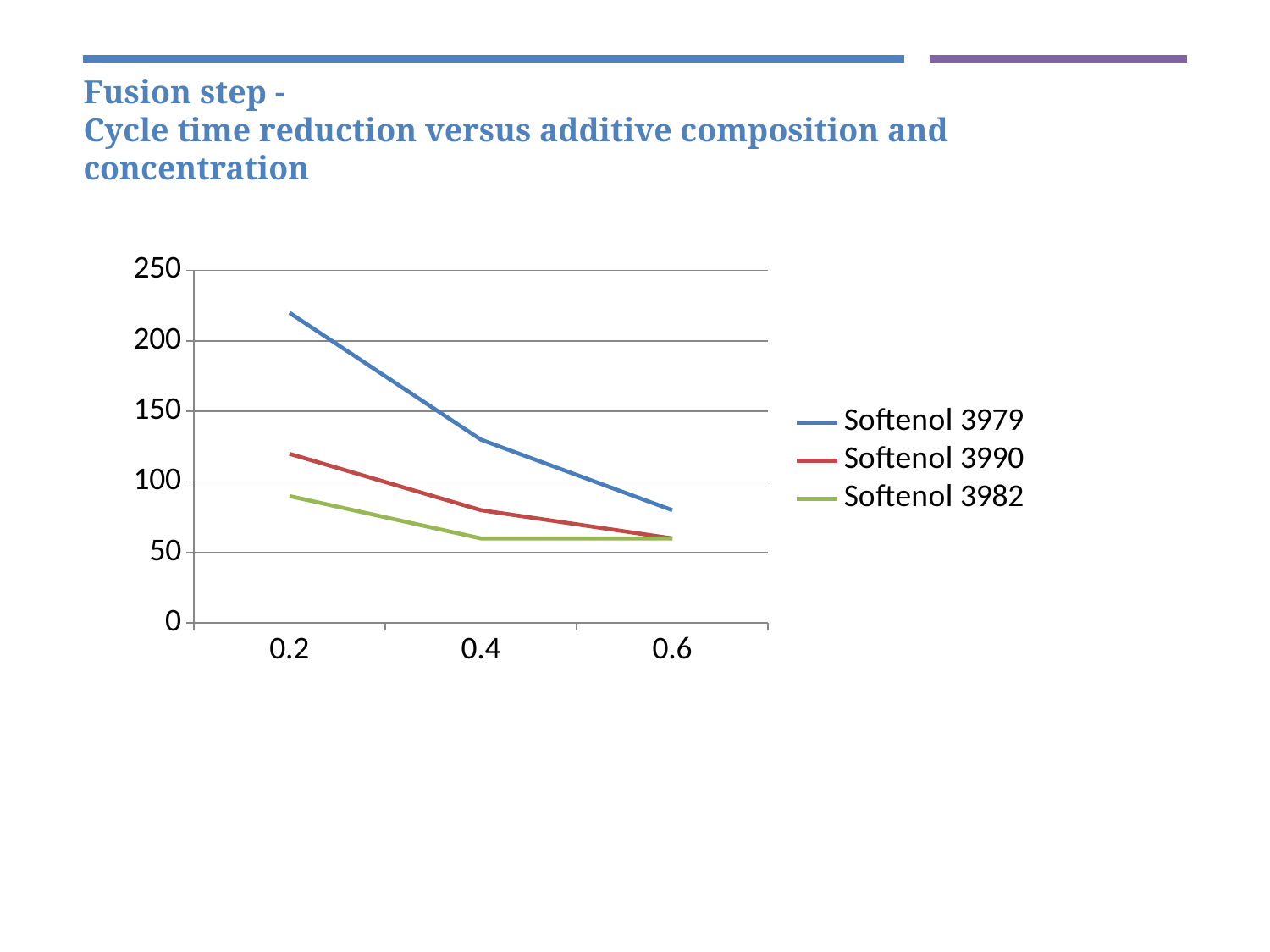
Which colour is used for the Softenol 3982 line? green At 0.4, which is larger: the value for Softenol 3979 or the value for Softenol 3990? Softenol 3979 Which series has the lowest value at 0.2? Softenol 3982 Is the value for Softenol 3979 at 0.2 greater or less than 200? greater Which series has the highest value at 0.2? Softenol 3979 What kind of chart is shown on the slide? line chart Do the values for Softenol 3979 rise or fall as the x axis goes from 0.2 to 0.6? fall Is the value for Softenol 3979 at 0.6 greater or less than 100? less Is the value for Softenol 3990 at 0.2 greater or less than 100? greater How many series does the legend list? 3 How many points are plotted along the x axis for each series? 3